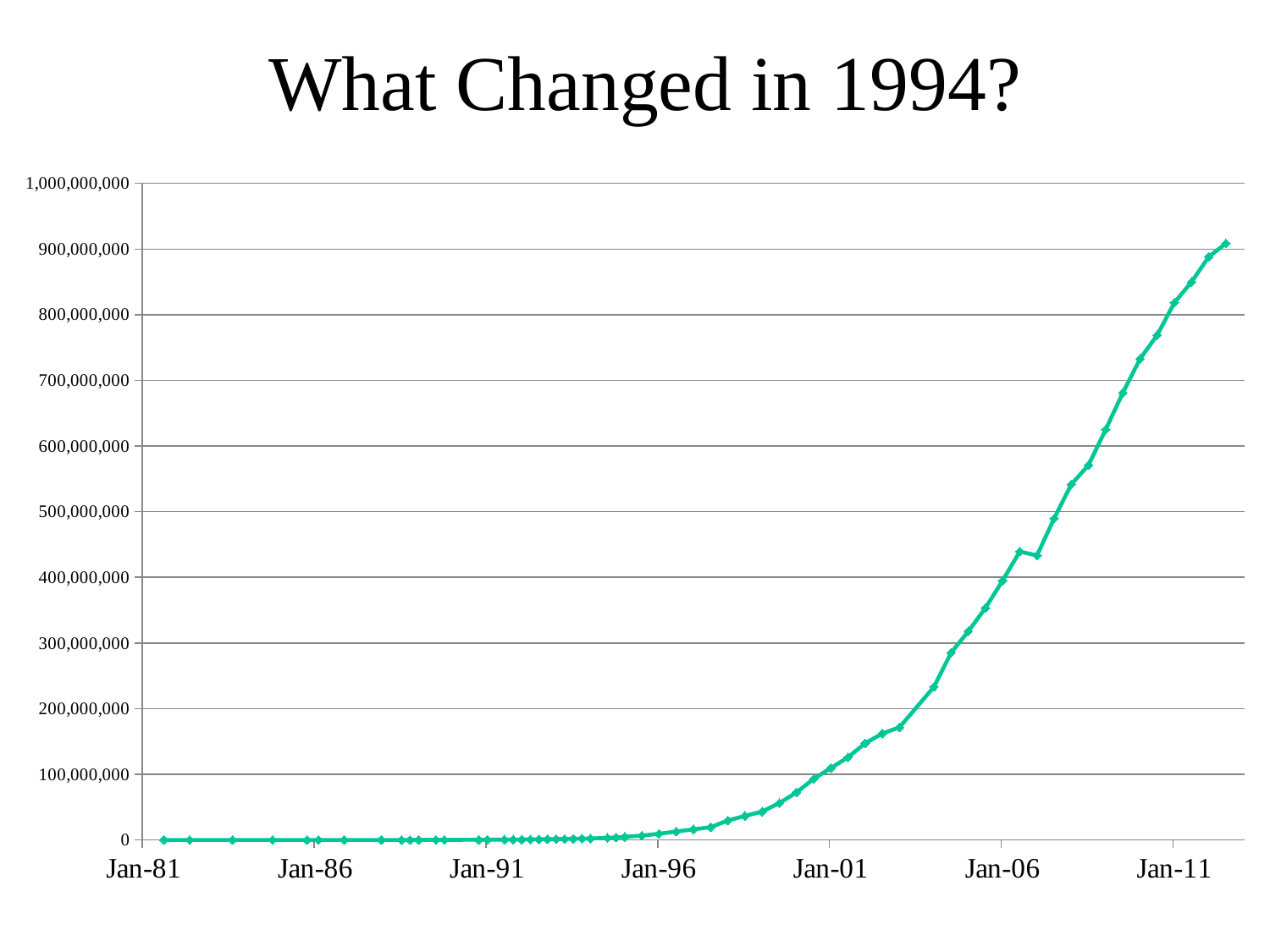
Which is larger, the value at Jan-86 or the value at Jan-11? Jan-11 Is the value at Jan-11 greater or less than 700,000,000? greater Is the value at Jan-91 greater or less than 100,000,000? less Do the plotted values generally rise or fall from Jan-81 to the end of the series? rise How many labelled tick marks are shown on the horizontal axis? 7 Is the value at Jan-06 greater or less than 300,000,000? greater What is the title of the slide containing the chart? What Changed in 1994? What is the maximum value shown on the vertical axis? 1,000,000,000 Which is larger, the value at Jan-01 or the value at Jan-06? Jan-06 What kind of chart is shown on the slide? line chart